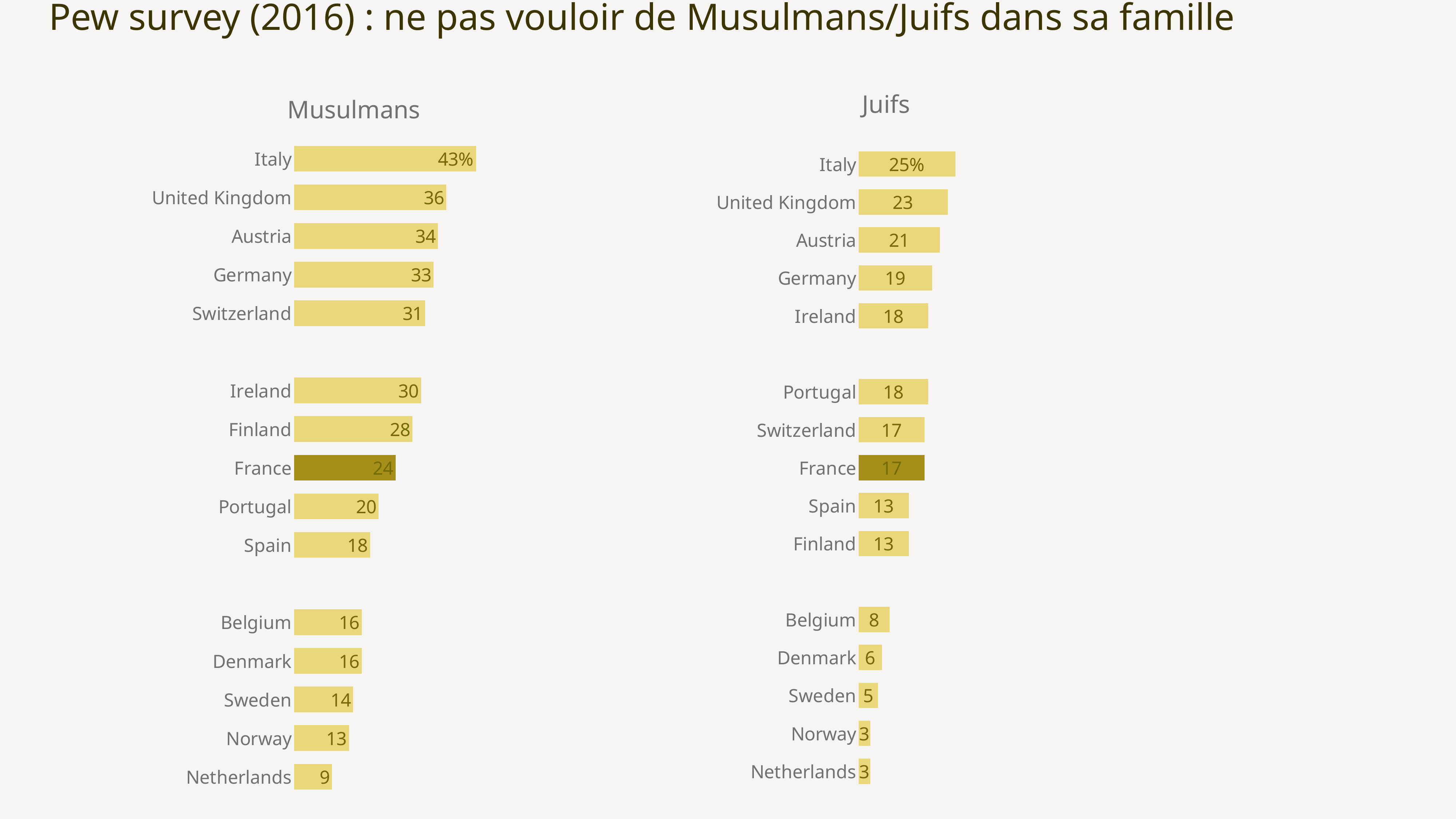
In the Musulmans chart, what is the difference between the values for United Kingdom and Spain? 18 In the Juifs chart, what is the value for Germany? 19 How many countries are shown in the Musulmans chart? 15 In the Juifs chart, which country's bar is shown in a darker colour than the others? France In the Juifs chart, what is the difference between the values for Italy and France? 8 In the Musulmans chart, which country has the lowest value? Netherlands In the Juifs chart, which country has the highest value? Italy In the Musulmans chart, which is larger, the value for Ireland or the value for Portugal? Ireland In the Musulmans chart, what is the value for France? 24 In the Juifs chart, which is larger, the value for Belgium or the value for Spain? Spain In the Musulmans chart, what is the value for Italy? 43% What kind of chart is the Juifs chart? Bar chart